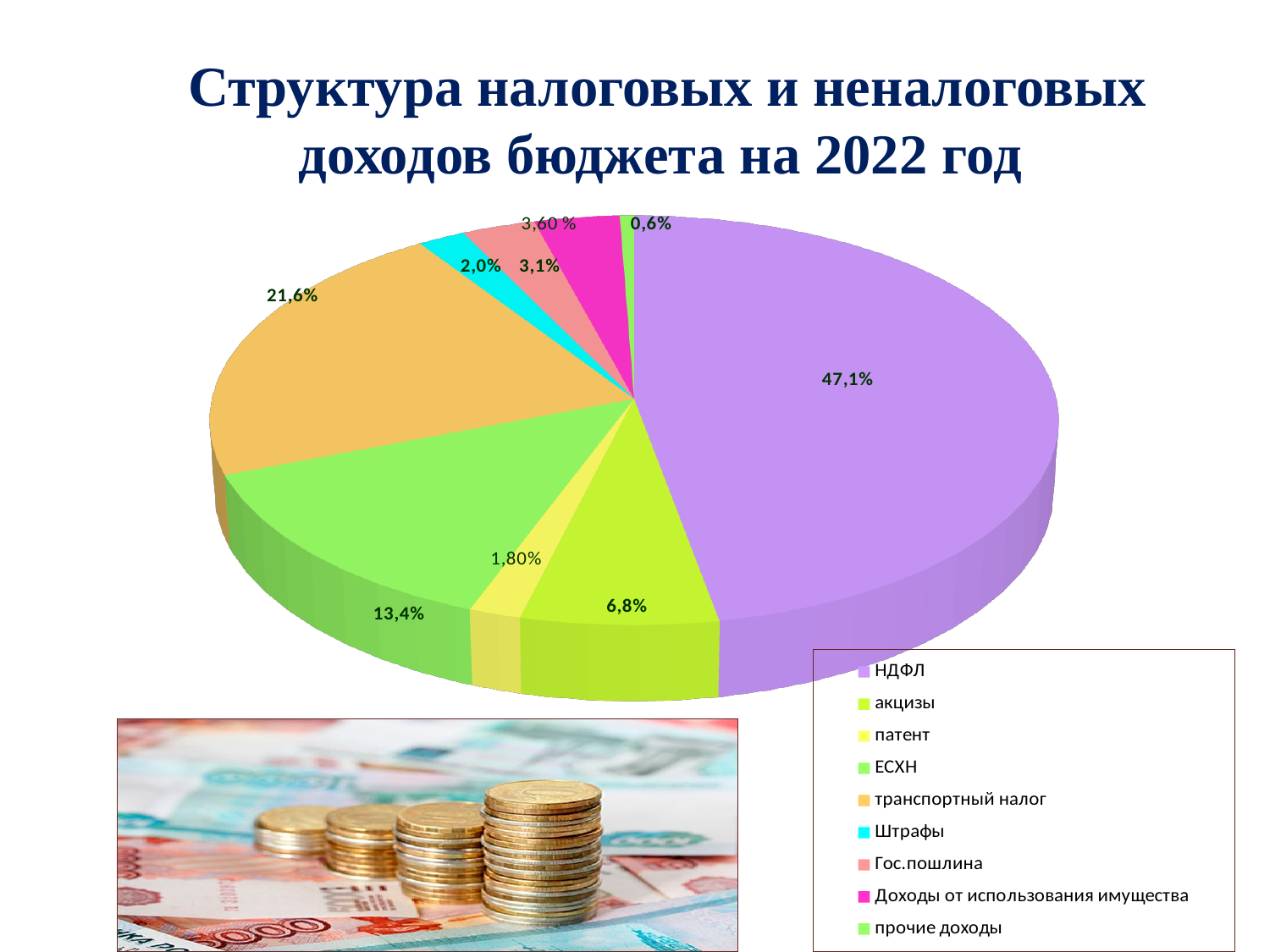
Which has a larger share, ЕСХН or акцизы? ЕСХН What share of the pie does акцизы have? 6,8% What is the title of the chart? Структура налоговых и неналоговых доходов бюджета на 2022 год Which category has the smallest share of the pie? прочие доходы What share of the pie does транспортный налог have? 21,6% What type of chart is shown on the slide? pie chart What share of the pie does Штрафы have? 2,0% What is the difference between the shares of НДФЛ and транспортный налог? 25,5% How many categories does the legend list? 9 What share of the pie does НДФЛ have? 47,1% What share of the pie does ЕСХН have? 13,4% Which category has the largest share of the pie? НДФЛ